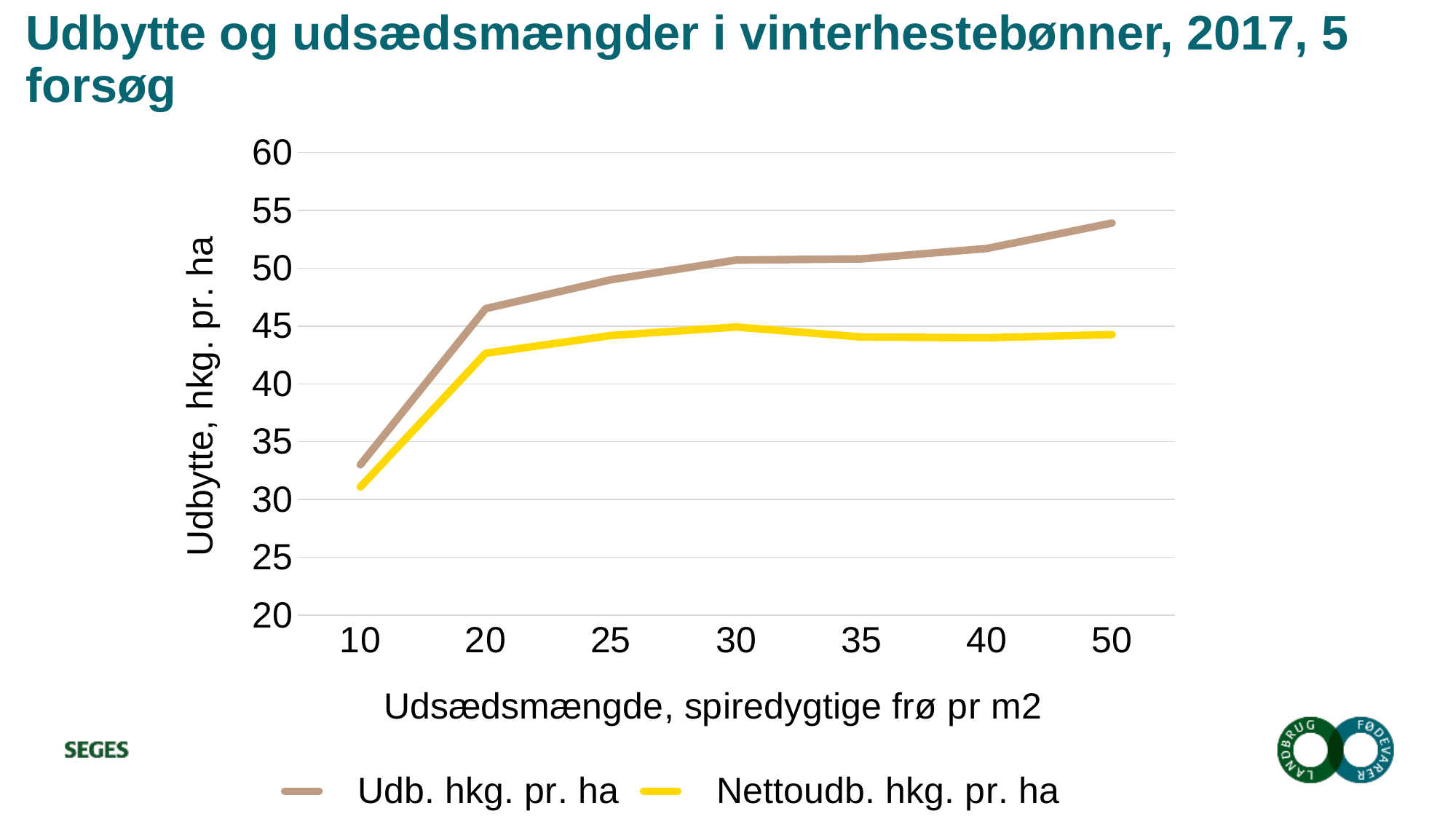
How many seed-rate points are plotted along the x axis? 7 At which seed rate is the Udb. hkg. pr. ha line lowest? 10 What kind of chart is shown on the slide? line chart Does the Udb. hkg. pr. ha line generally rise or fall as the seed rate increases from 10 to 50? rise Is the value for Udb. hkg. pr. ha at seed rate 50 greater or less than 50? greater At which seed rate is the Nettoudb. hkg. pr. ha line lowest? 10 Is the value for Udb. hkg. pr. ha at seed rate 10 greater or less than 35? less What is the title of the x axis? Udsædsmængde, spiredygtige frø pr m2 Is the value for Nettoudb. hkg. pr. ha at seed rate 30 greater or less than 50? less How many series does the legend list? 2 At which seed rate is the Udb. hkg. pr. ha line highest? 50 At seed rate 30, which series has the larger value, Udb. hkg. pr. ha or Nettoudb. hkg. pr. ha? Udb. hkg. pr. ha